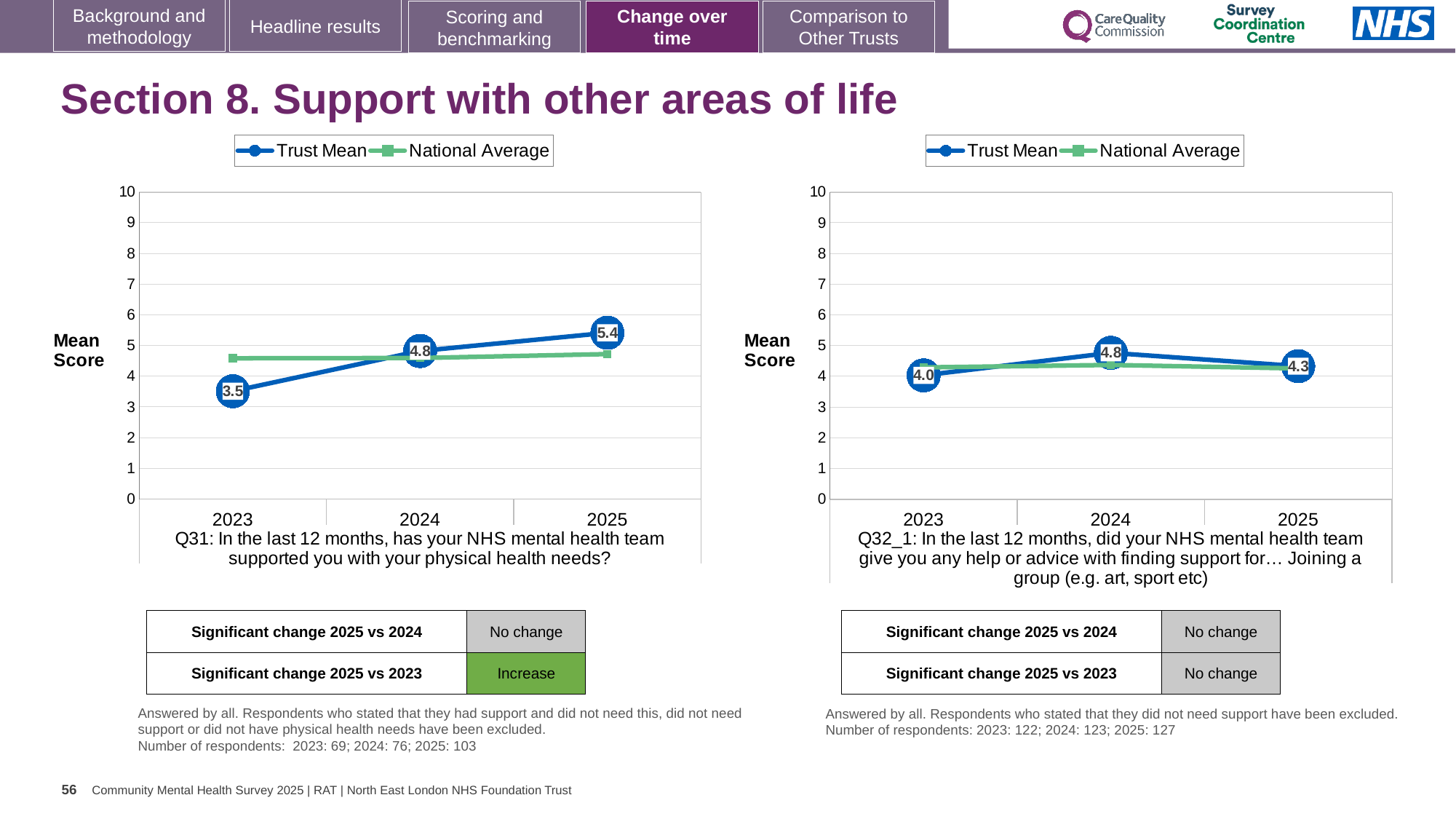
On the Q31 chart (left), what is the Trust Mean for 2023? 3.5 On the Q31 chart (left), does the Trust Mean rise or fall from 2023 to 2025? rise On the Q32_1 chart (right), what is the Trust Mean for 2025? 4.3 On the Q31 chart (left), what is the Trust Mean for 2025? 5.4 On the Q31 chart (left), is the Trust Mean for 2023 larger or smaller than the Trust Mean for 2024? smaller On the Q32_1 chart (right), which year has the lowest Trust Mean? 2023 On the Q32_1 chart (right), is the Trust Mean for 2024 greater or less than 5? less What kind of chart is the Q31 chart (left)? line chart On the Q31 chart (left), what is the difference between the Trust Mean for 2025 and 2023? 1.9 How many series does the legend of the Q32_1 chart (right) list? 2 On the Q32_1 chart (right), what is the Trust Mean for 2024? 4.8 On the Q31 chart (left), which year has the highest Trust Mean? 2025